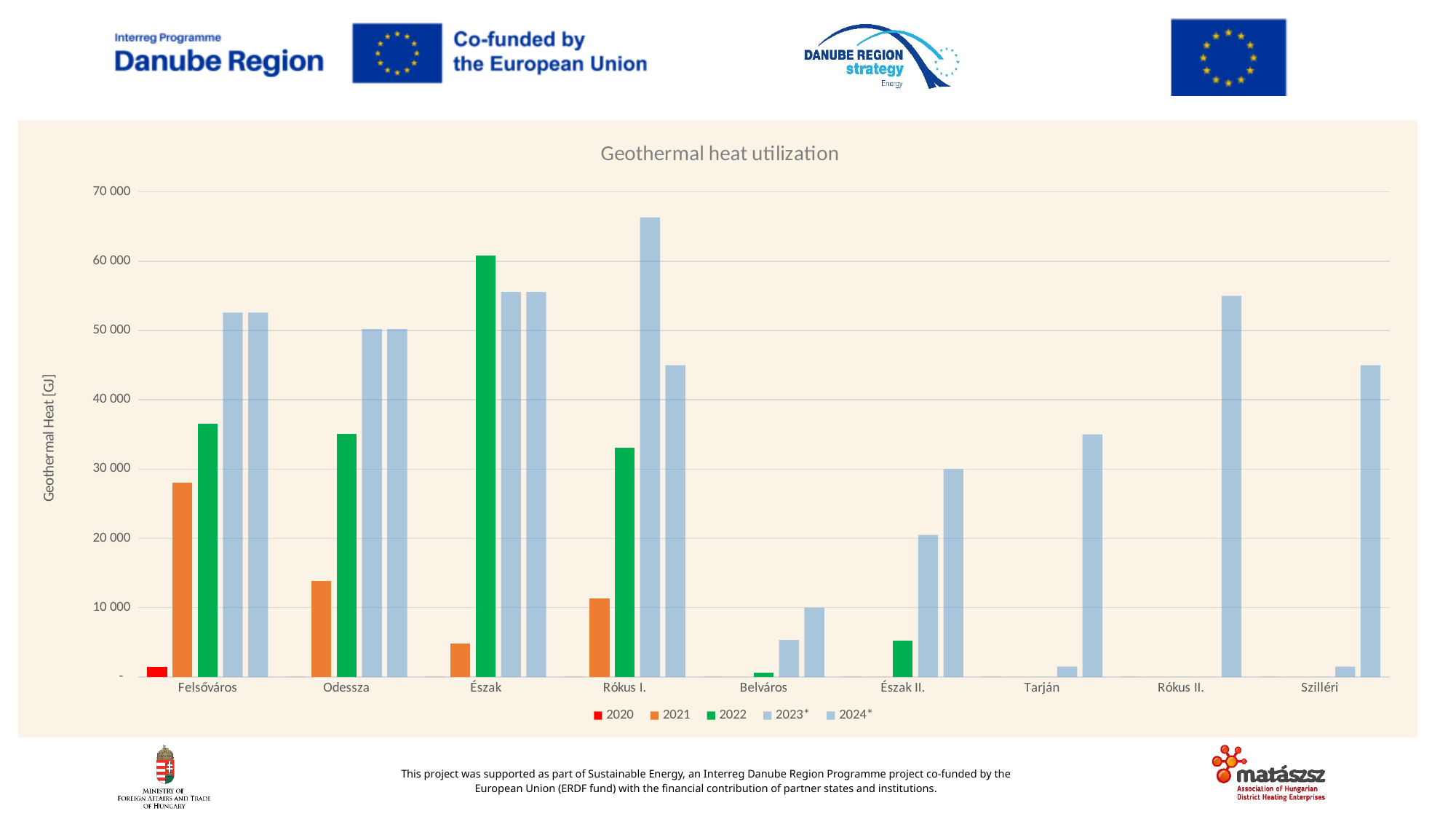
Is the 2021 value for Felsőváros greater or less than 30 000? less Do the values for Belváros rise or fall from 2022 to 2024*? rise Which category has the highest 2022 bar? Észak Is the 2023* value for Rókus I. greater or less than 60 000? greater What type of chart is shown on the slide? Bar chart How many categories (districts) are shown on the x axis of the chart? 9 What is the title of the chart? Geothermal heat utilization How many series does the chart legend list? 5 Which has the larger 2024* value, Észak II. or Belváros? Észak II. Which category has the highest 2023* bar? Rókus I. Which series is shown in red in the chart? 2020 Is the 2024* value for Tarján greater or less than 30 000? greater